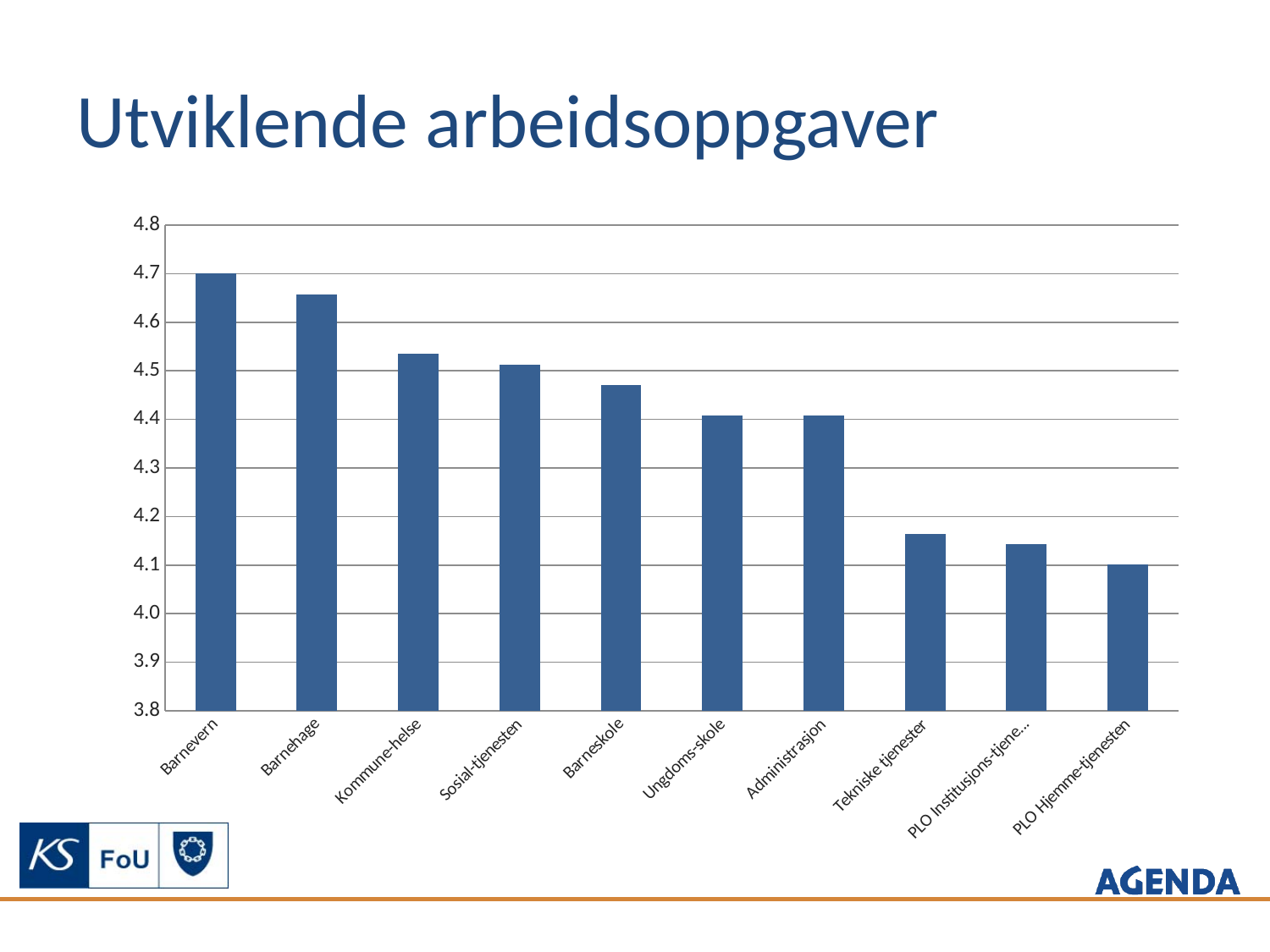
Is the value for Tekniske tjenester greater or less than 4.2? less What is the title of the chart on the slide? Utviklende arbeidsoppgaver Is the value for Barnehage greater or less than 4.6? greater Which is larger, the value for Tekniske tjenester or the value for Barneskole? Barneskole Do the values rise or fall moving from left to right along the x axis? fall Is the value for Barneskole greater or less than 4.5? less Which is larger, the value for Barnehage or the value for Kommune-helse? Barnehage What is the value for Barnevern? 4.7 What kind of chart is shown on the slide? bar chart Which category has the lowest value in the chart? PLO Hjemme-tjenesten Which category has the highest value in the chart? Barnevern How many categories are shown on the x axis of the chart? 10